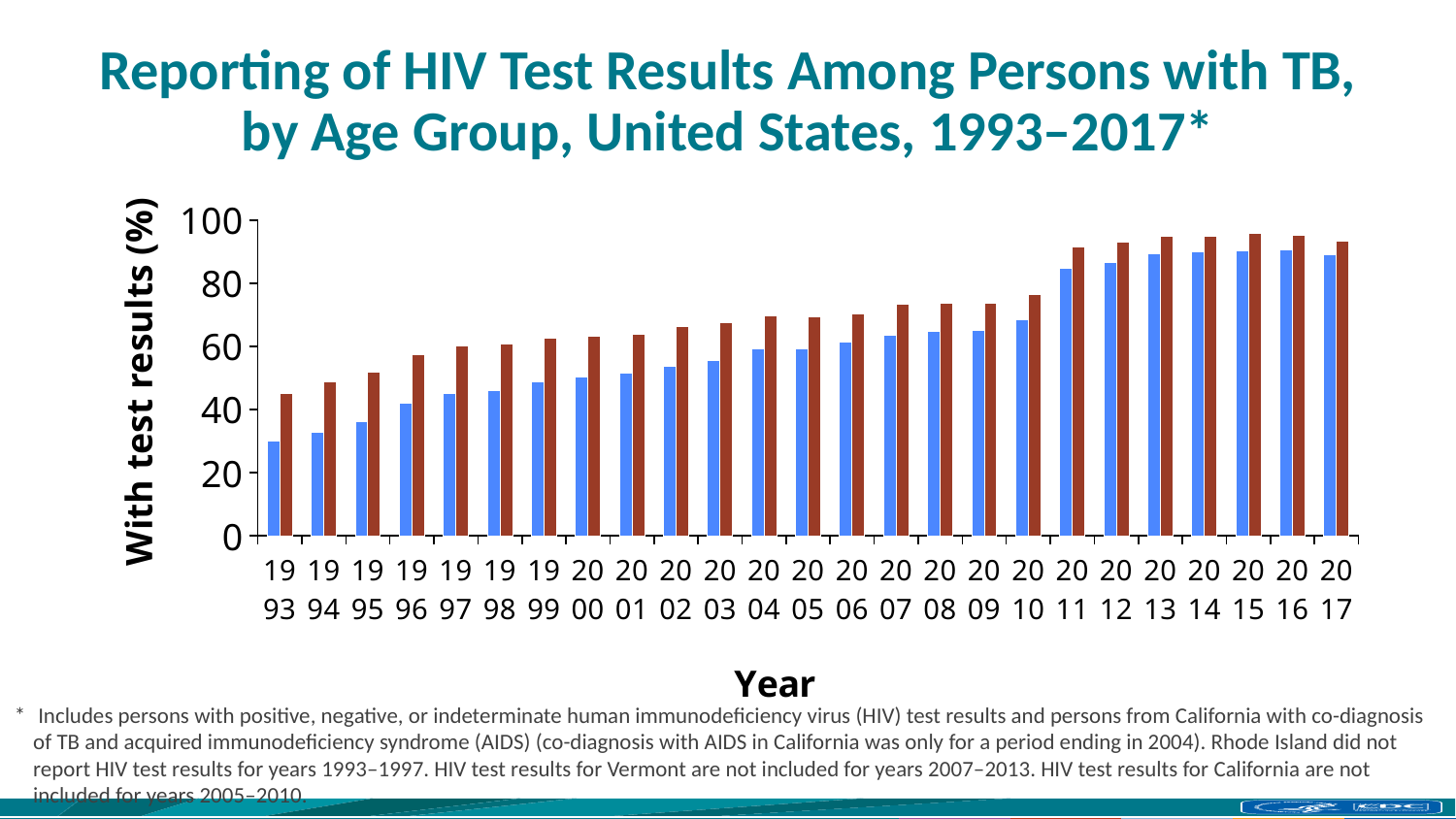
What kind of chart is shown on the slide? bar chart In which year is the red bar lowest? 1993 What is the title of the x axis of the chart? Year In which year is the blue bar lowest? 1993 Do the blue bars generally rise or fall from 1993 to 2017? rise Is the value of the blue bar for 1993 greater or less than 40? less How many years are shown along the x axis of the chart? 25 Is the value of the blue bar for 2017 greater or less than 80? greater What is the title of the y axis of the chart? With test results (%) Is the value of the red bar for 1993 greater or less than 40? greater For 2017, which bar is taller, the blue bar or the red bar? the red bar